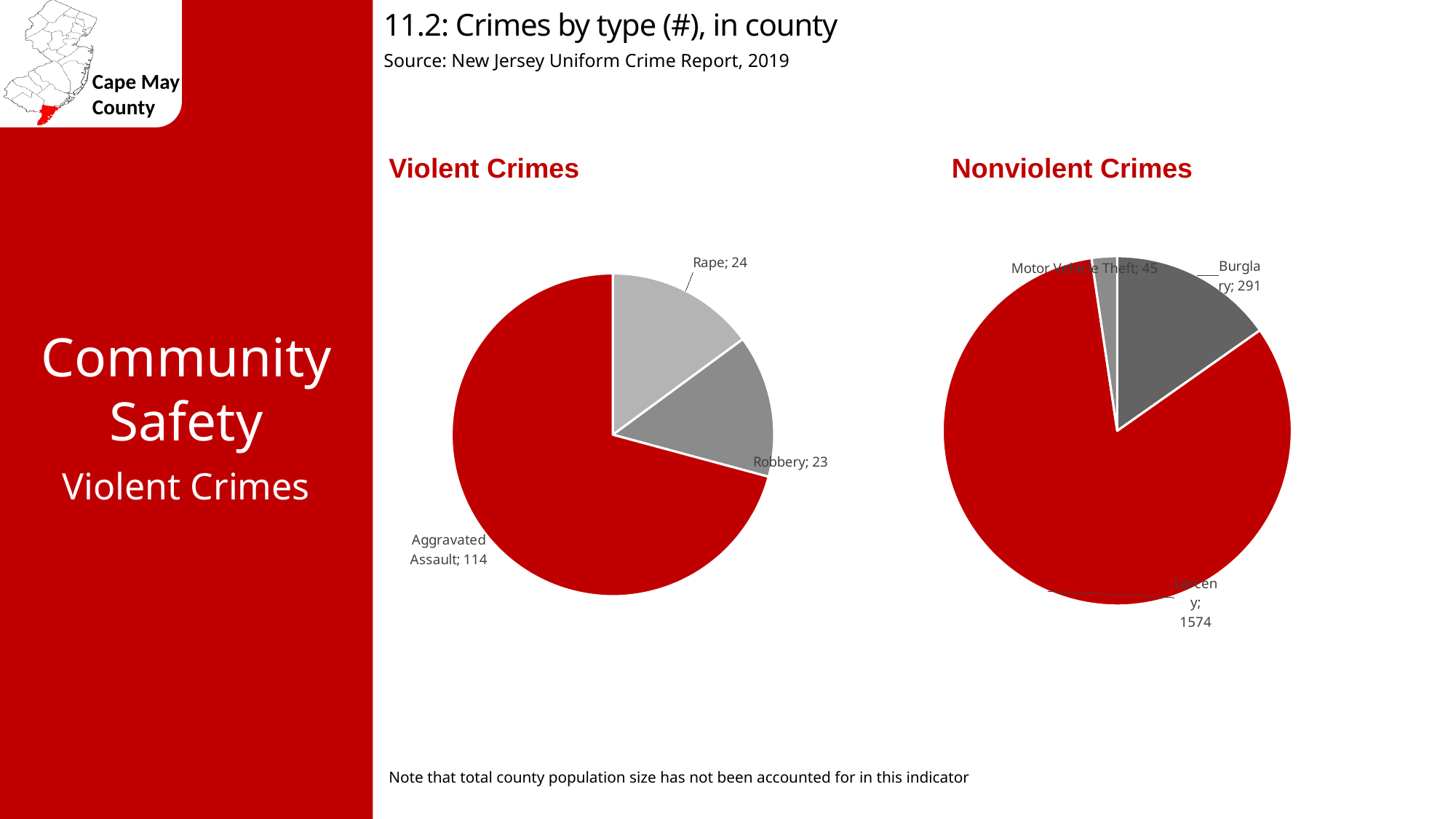
In the Nonviolent Crimes chart, which crime type has the smallest slice? Motor Vehicle Theft What kind of chart is the Violent Crimes chart? pie chart In the Nonviolent Crimes chart, what is the value for Motor Vehicle Theft? 45 In the Nonviolent Crimes chart, what is the value for Burglary? 291 In the Nonviolent Crimes chart, which is larger, Burglary or Larceny? Larceny In the Violent Crimes chart, which crime type has the largest slice? Aggravated Assault In the Nonviolent Crimes chart, what is the difference between Larceny and Burglary? 1283 What is the source cited for the charts on the slide? New Jersey Uniform Crime Report, 2019 How many slices does the Violent Crimes pie chart have? 3 In the Violent Crimes chart, what is the value for Rape? 24 In the Violent Crimes chart, what is the difference between Rape and Robbery? 1 In the Violent Crimes chart, what is the value for Aggravated Assault? 114